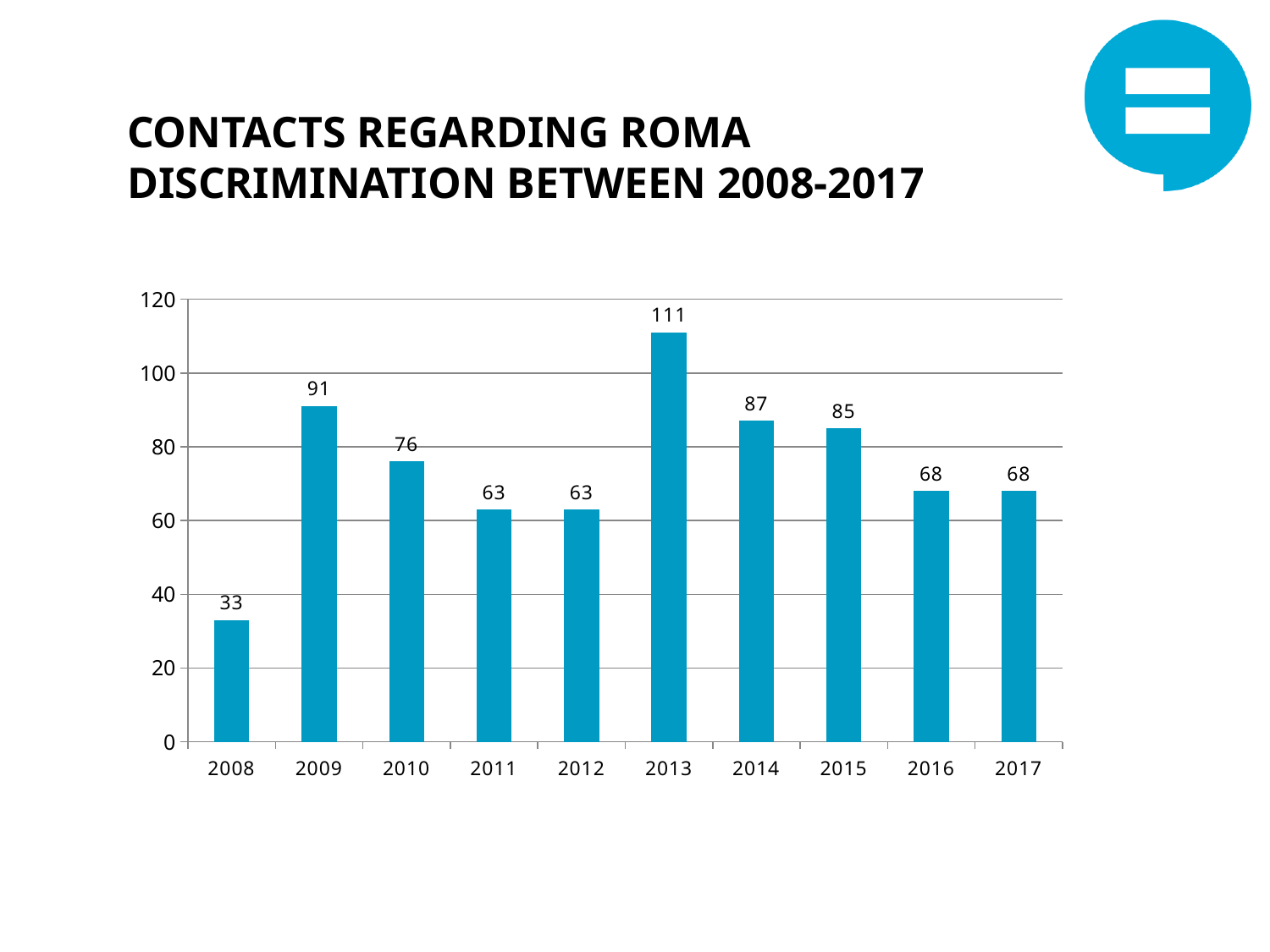
What is the difference between the values for 2013 and 2014? 24 Which year has the highest value? 2013 Do the values rise or fall from 2013 to 2016? fall What is the value for 2015? 85 How many years are shown on the x axis? 10 What is the value for 2013? 111 Is the value for 2009 greater or less than 80? greater Which year has the lowest value? 2008 What is the difference between the values for 2009 and 2008? 58 Which is larger, the value for 2010 or the value for 2016? 2010 What kind of chart is shown on the slide? bar chart What is the value for 2008? 33